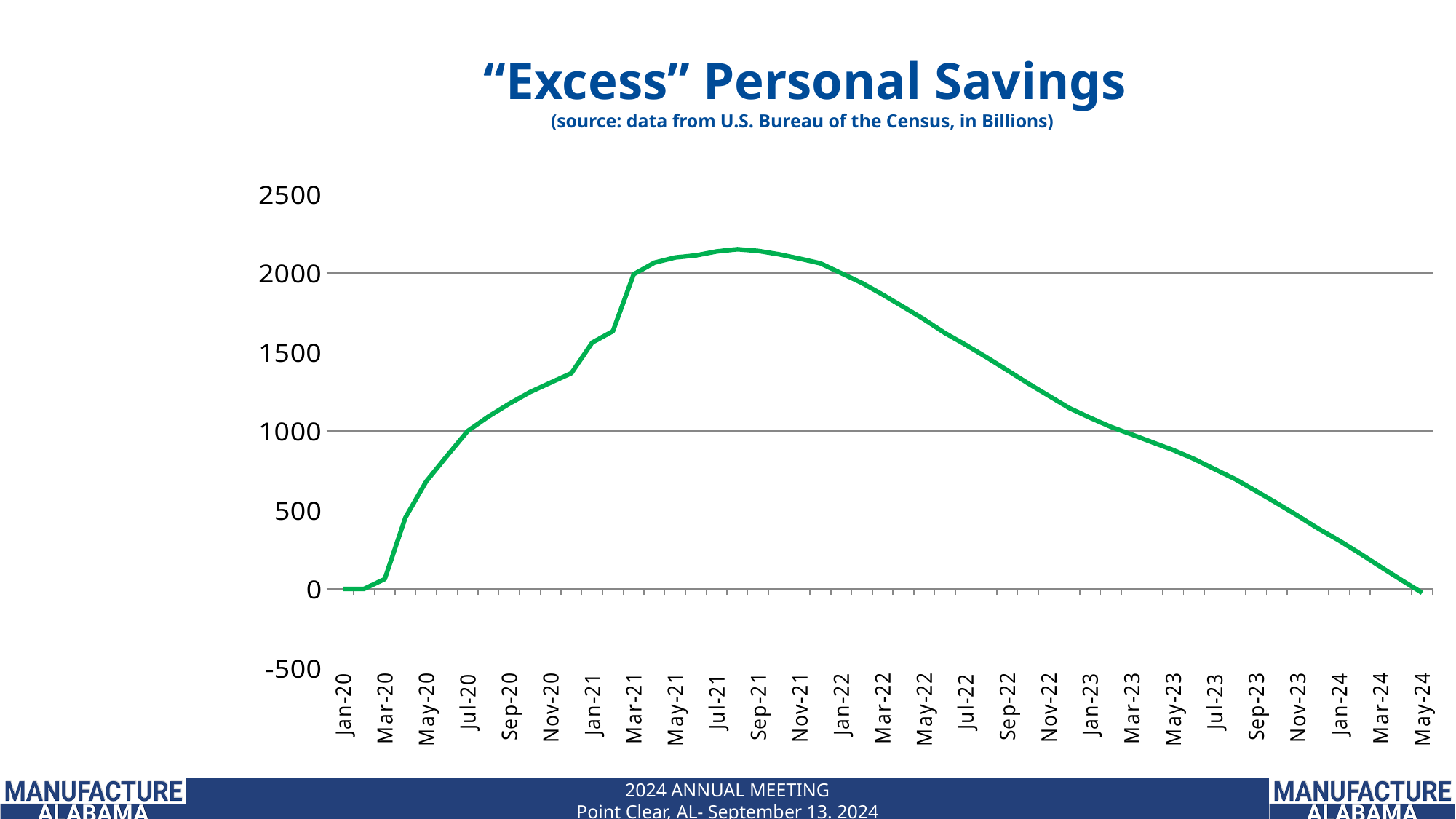
Do the values rise or fall between Jan-20 and Jul-21? rise Is the value for Sep-22 greater or less than 1500? less Is the value for May-21 greater or less than 2000? greater In which year does the line reach its highest point? 2021 Is the value for Jan-24 greater or less than 500? less What kind of chart is shown on the slide? line chart Do the values rise or fall between Sep-21 and May-24? fall What is the title of the chart? "Excess" Personal Savings